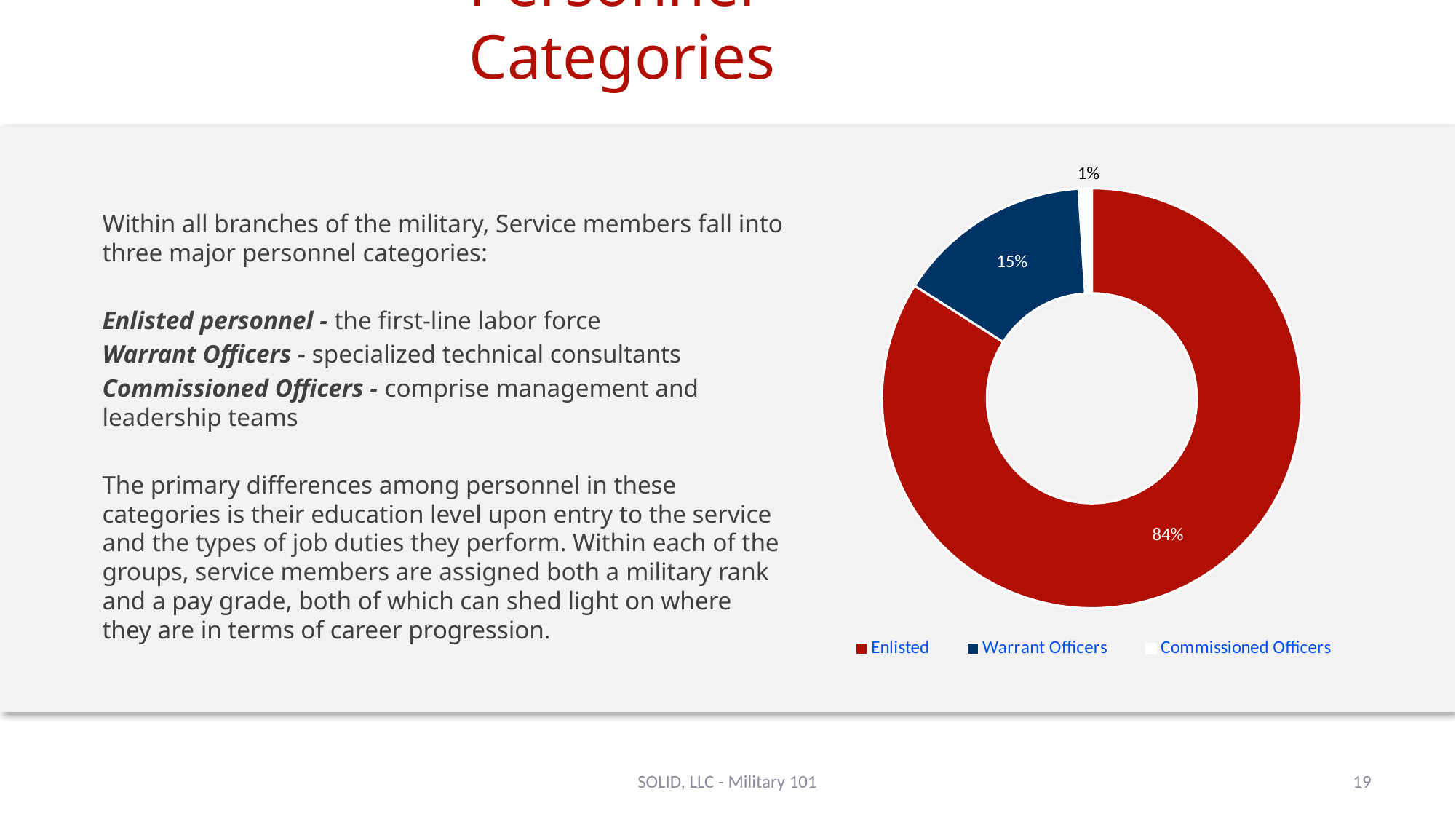
What colour is the Enlisted segment in the chart? Red What colour is the Warrant Officers segment in the chart? Dark blue What is the difference in percentage points between Warrant Officers and Commissioned Officers? 14 Which category has the largest share in the chart? Enlisted Which category has the smallest share in the chart? Commissioned Officers How many categories does the chart show? 3 What percentage of the doughnut chart is Commissioned Officers? 1% What percentage of the doughnut chart is Enlisted? 84% What percentage of the doughnut chart is Warrant Officers? 15% What kind of chart is shown on the slide? Doughnut chart Which is larger, the share for Warrant Officers or the share for Commissioned Officers? Warrant Officers What is the difference in percentage points between Enlisted and Warrant Officers? 69